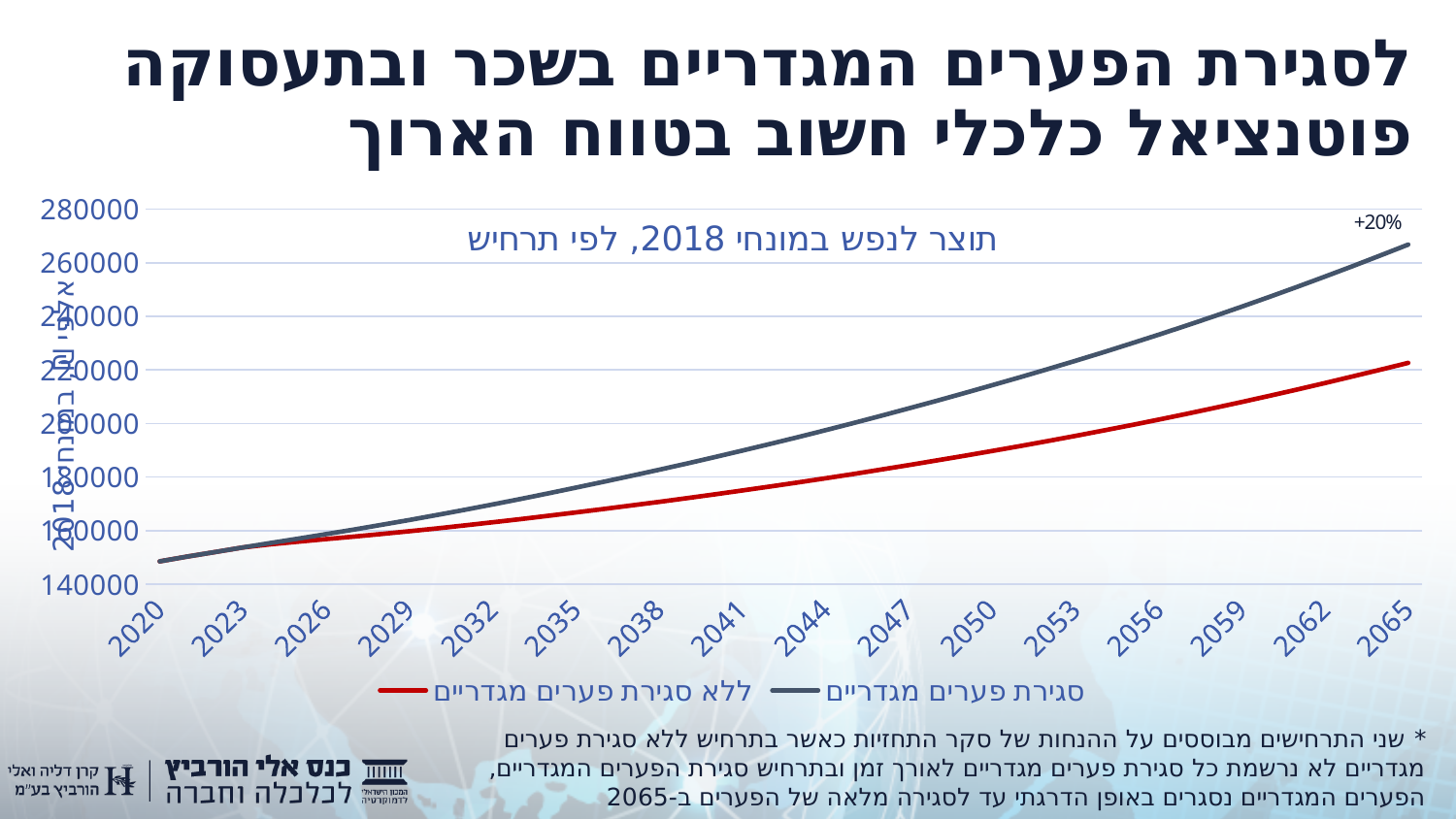
Is the value of the 'סגירת פערים מגדריים' series in 2020 greater or less than 160000? less Do the values of the 'ללא סגירת פערים מגדריים' series rise or fall along the x axis? rise How many series does the legend list? 2 Is the value of the 'סגירת פערים מגדריים' series in 2065 greater or less than 260000? greater What kind of chart is shown on the slide? line chart Is the value of the 'ללא סגירת פערים מגדריים' series in 2065 greater or less than 240000? less Do the values of the 'סגירת פערים מגדריים' series rise or fall from 2020 to 2065? rise What percentage annotation is printed at the end of the upper line in the chart? +20% How many year labels are shown along the x axis? 16 In 2065, which series has the higher value: 'סגירת פערים מגדריים' or 'ללא סגירת פערים מגדריים'? סגירת פערים מגדריים What is the title of the chart? תוצר לנפש במונחי 2018, לפי תרחיש